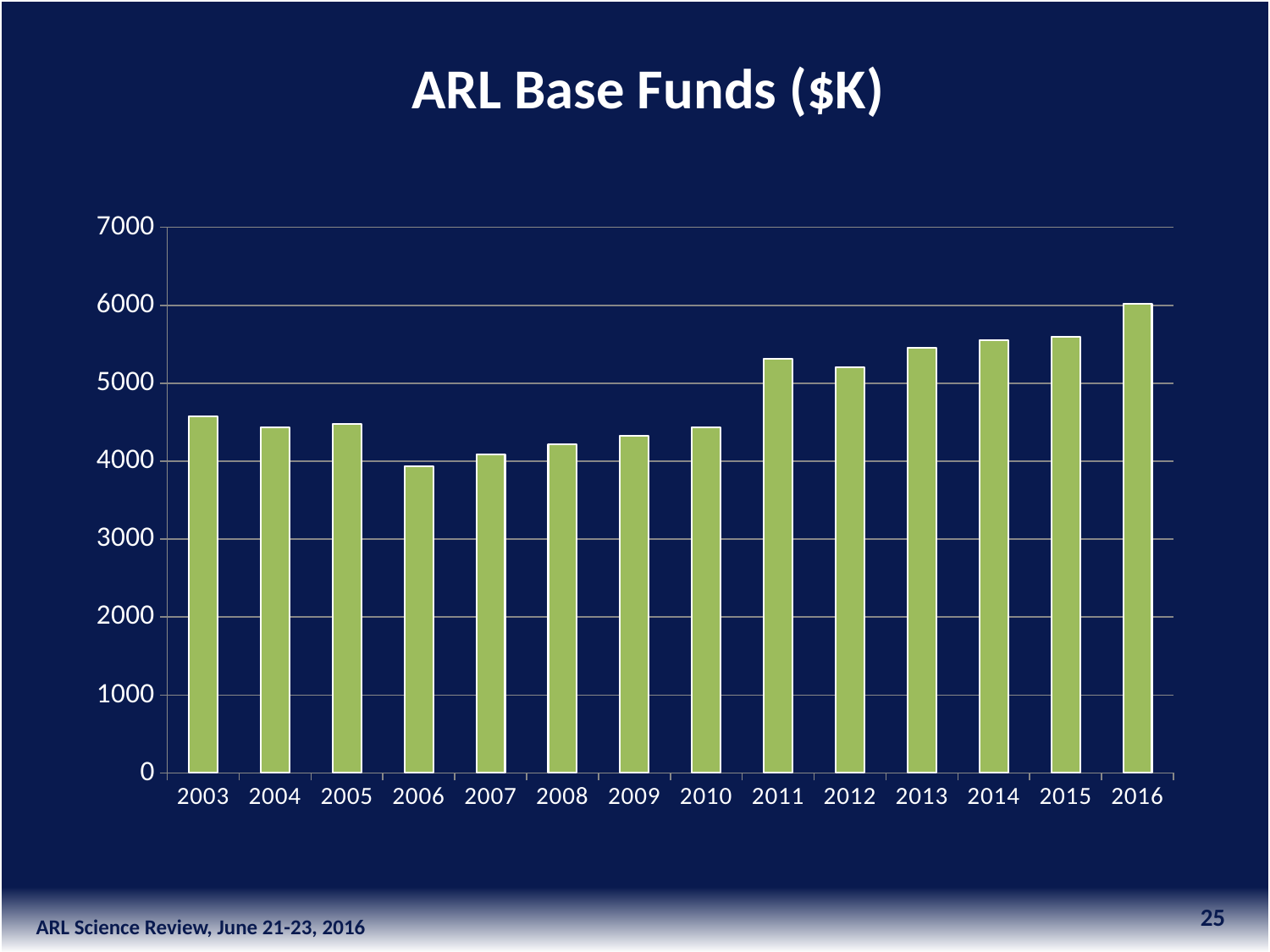
Is the value for 2006 greater or less than 4000? less Which year has the lowest ARL base funds? 2006 Is the value for 2011 greater or less than 5000? greater What is the title of the chart? ARL Base Funds ($K) Is the value for 2013 greater or less than 6000? less Which year has the larger value, 2010 or 2011? 2011 Which year has the highest ARL base funds? 2016 Which year has the larger value, 2003 or 2006? 2003 Do the values rise or fall from 2011 to 2016? rise How many years are shown on the x axis of the chart? 14 What kind of chart is shown on the slide? bar chart